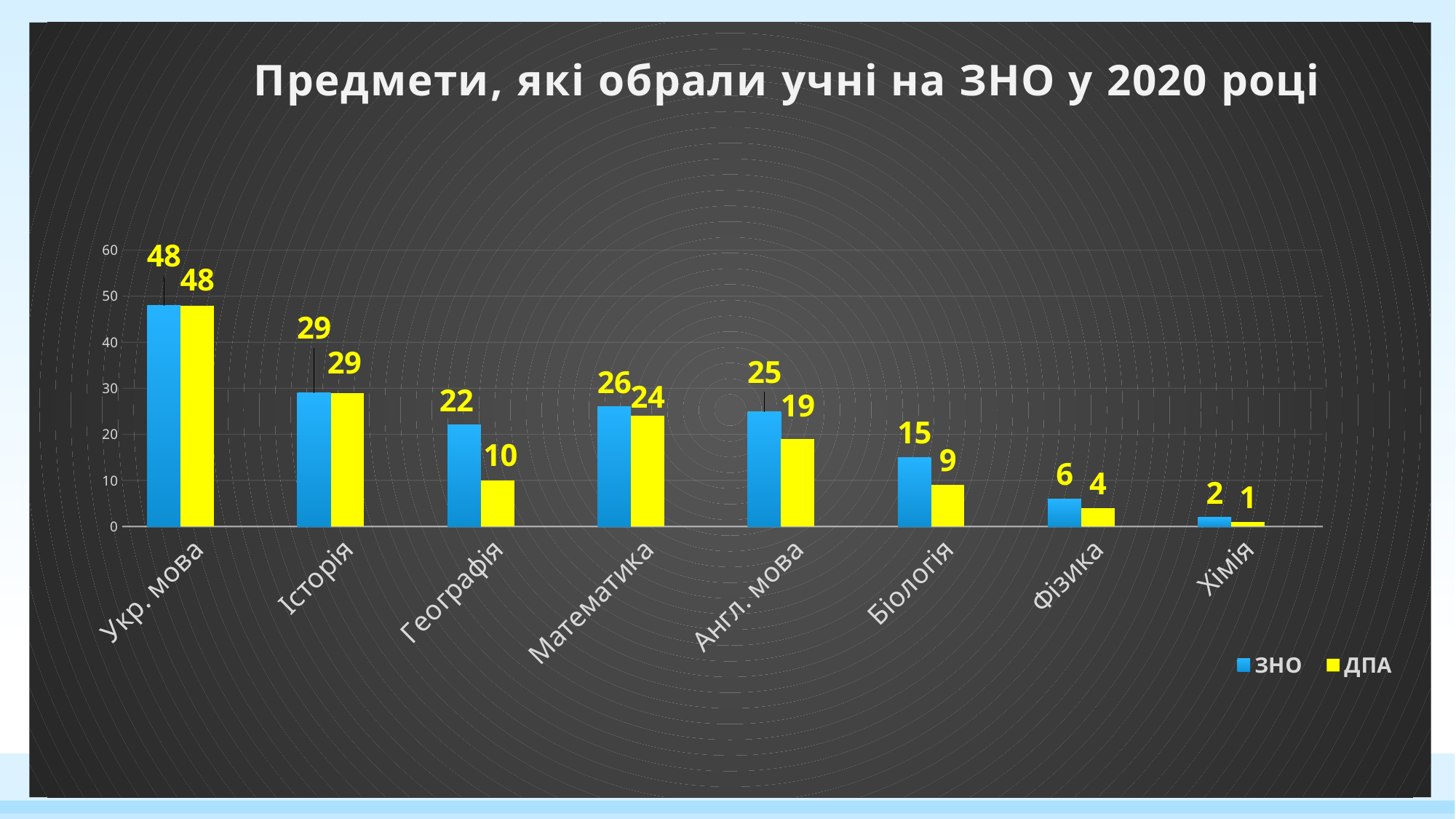
Which is larger for Біологія: the ЗНО value or the ДПА value? ЗНО What is the title of the chart? Предмети, які обрали учні на ЗНО у 2020 році How many series does the legend list? 2 What kind of chart is shown on the slide? bar chart What is the difference between the ЗНО and ДПА values for Географія? 12 How many categories are shown on the x axis? 8 What is the difference between the ЗНО values for Укр. мова and Історія? 19 Which category has the lowest ДПА value? Хімія What is the ДПА value for Англ. мова? 19 What is the ДПА value for Математика? 24 What is the ЗНО value for Географія? 22 Which category has the highest ЗНО value? Укр. мова